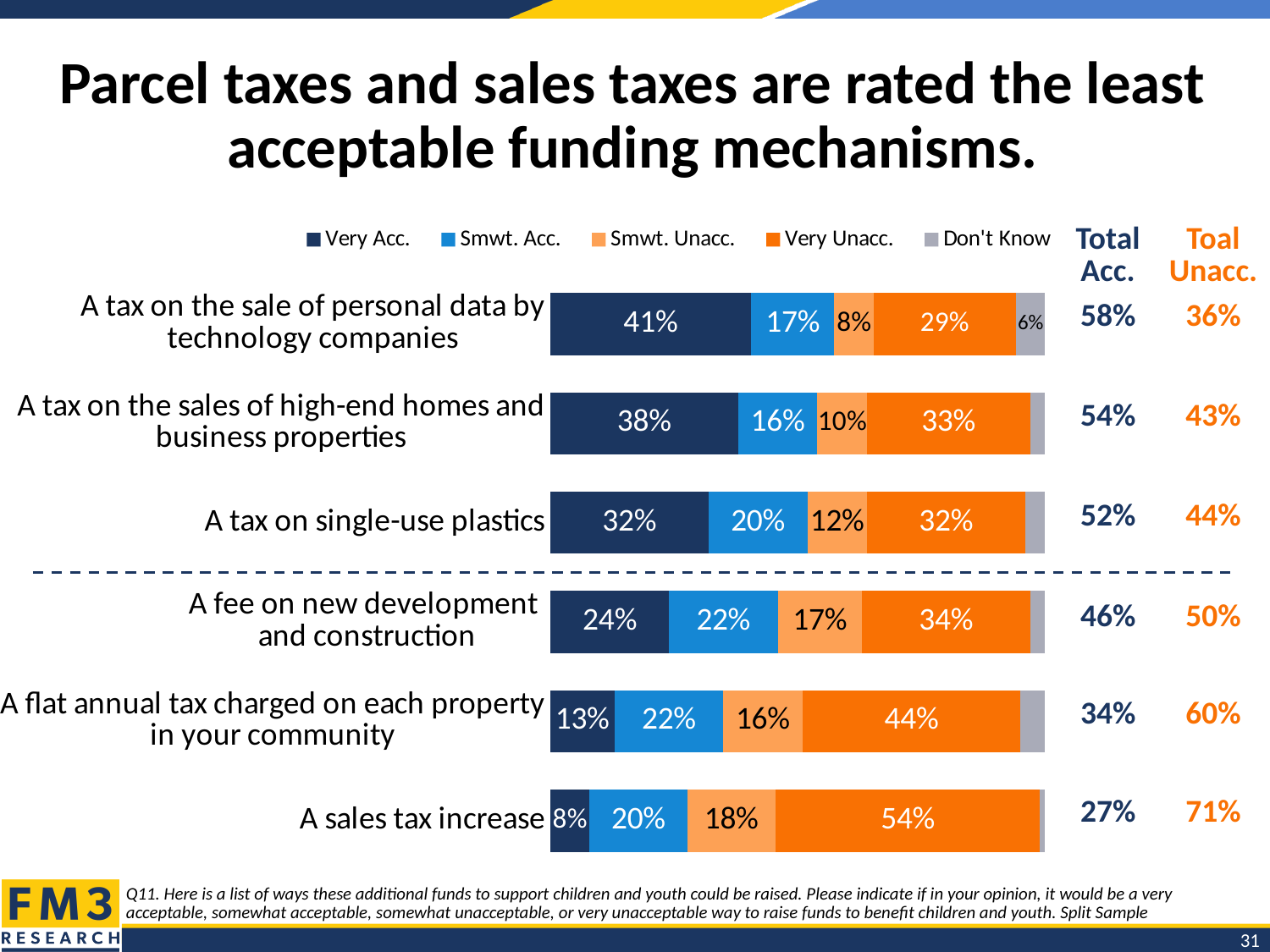
How many funding mechanisms are shown in the chart? 6 What is the Total Acc. value shown for a fee on new development and construction? 46% What percentage rated a tax on the sale of personal data by technology companies as Very Acc.? 41% What is the Smwt. Acc. value for a tax on single-use plastics? 20% What is the difference between the Very Unacc. values for a flat annual tax charged on each property in your community and a fee on new development and construction? 10% How many series does the legend list? 5 Which funding mechanism has the highest Very Unacc. value? A sales tax increase What kind of chart is shown on the slide? Stacked bar chart Which is larger: the Very Acc. value for a tax on the sales of high-end homes and business properties or the Very Acc. value for a tax on single-use plastics? A tax on the sales of high-end homes and business properties Which funding mechanism has the lowest Very Acc. value? A sales tax increase What is the Very Unacc. value for a sales tax increase? 54% What is the Don't Know value for a tax on the sale of personal data by technology companies? 6%